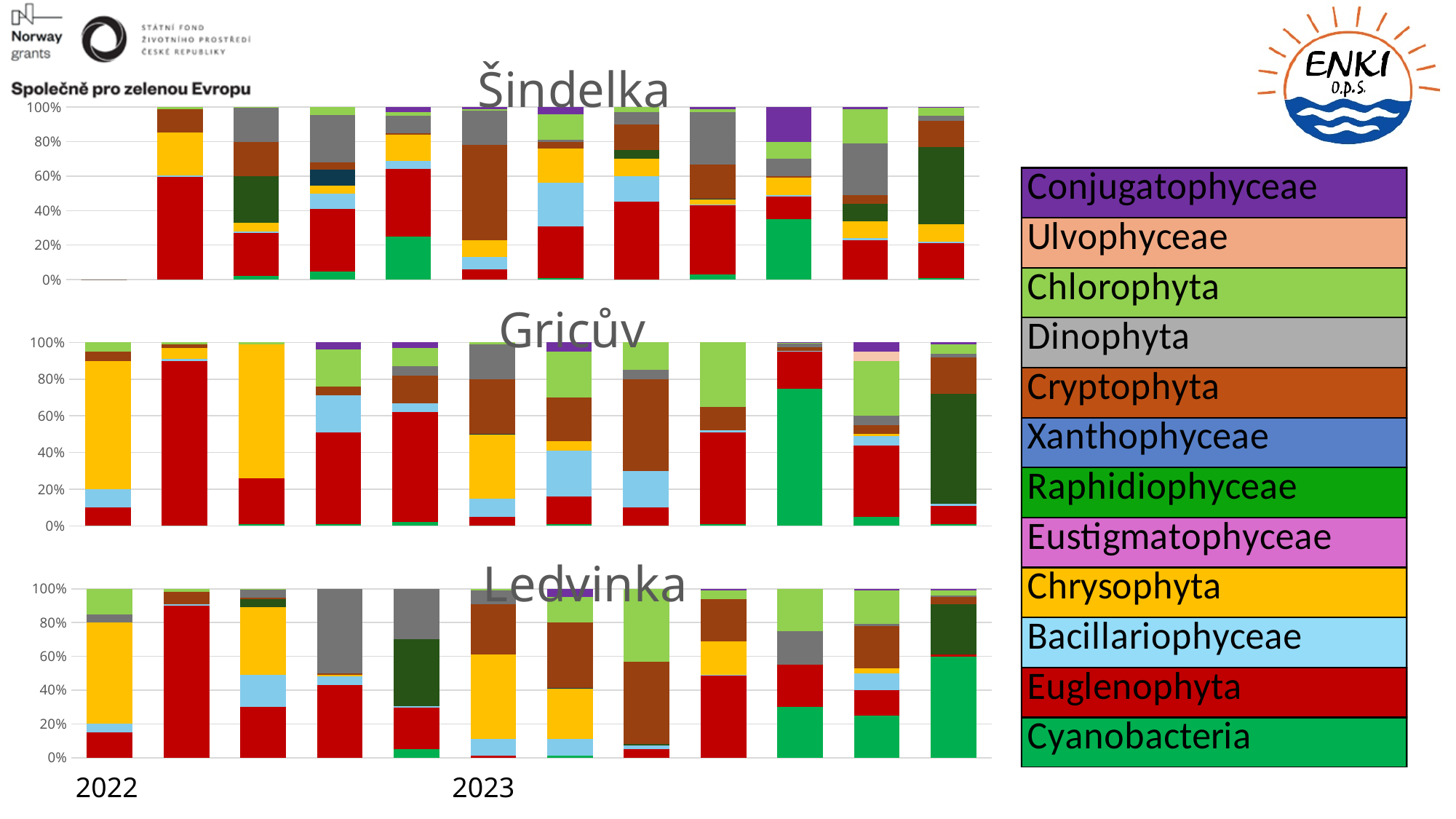
How many bars are plotted in the Ledvinka chart? 12 In the Gricův chart, is the Cyanobacteria value for the tenth bar greater or less than 60%? greater How many bars are plotted in the Gricův chart? 12 In the Šindelka chart, is the Euglenophyta value for the second bar greater or less than 40%? greater In the Gricův chart, is the Euglenophyta value for the second bar greater or less than 80%? greater What colour represents Euglenophyta in the legend? red How many series does the legend list? 12 What kind of chart is the Šindelka chart? stacked bar chart Which series is listed first (at the top) in the legend? Conjugatophyceae